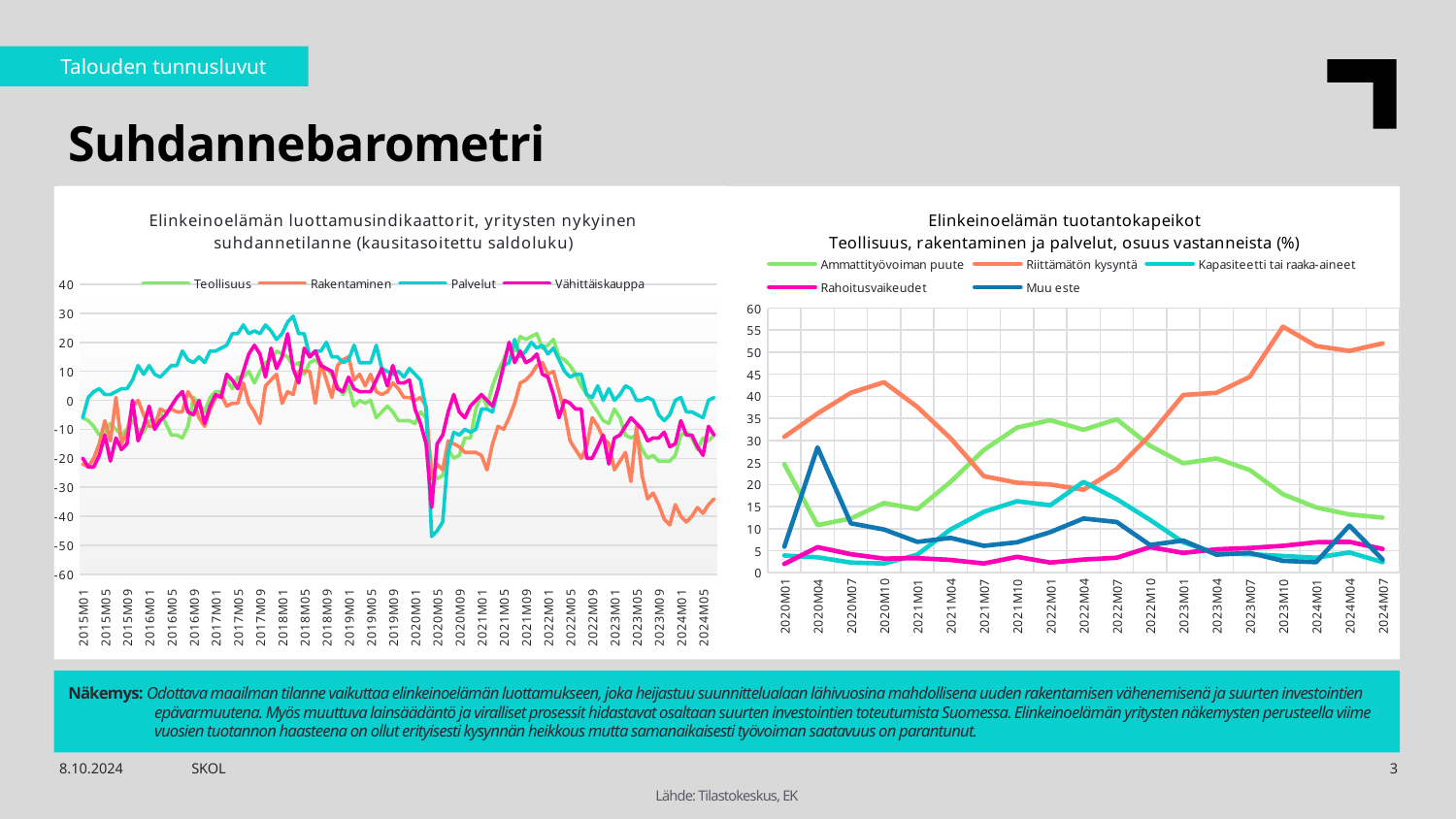
In the left chart "Elinkeinoelämän luottamusindikaattorit", is the value for Palvelut at 2018M01 greater or less than 20? greater In the left chart "Elinkeinoelämän luottamusindikaattorit", is the value for Rakentaminen at 2020M05 greater or less than -40? greater In the left chart "Elinkeinoelämän luottamusindikaattorit", which series reaches the lowest value around 2020M05? Palvelut In the right chart "Elinkeinoelämän tuotantokapeikot", which series is drawn in dark blue? Muu este How many series does the legend of the right chart "Elinkeinoelämän tuotantokapeikot" list? 5 How many series does the legend of the left chart "Elinkeinoelämän luottamusindikaattorit" list? 4 In the right chart "Elinkeinoelämän tuotantokapeikot", is the value for Ammattityövoiman puute at 2024M07 greater or less than 20? less What kind of chart is the left chart titled "Elinkeinoelämän luottamusindikaattorit"? line chart In the right chart "Elinkeinoelämän tuotantokapeikot", does Ammattityövoiman puute rise or fall between 2022M07 and 2024M07? fall In the right chart "Elinkeinoelämän tuotantokapeikot", which series has the highest value at 2024M07? Riittämätön kysyntä In the right chart "Elinkeinoelämän tuotantokapeikot", at 2020M01 which is larger: Riittämätön kysyntä or Ammattityövoiman puute? Riittämätön kysyntä